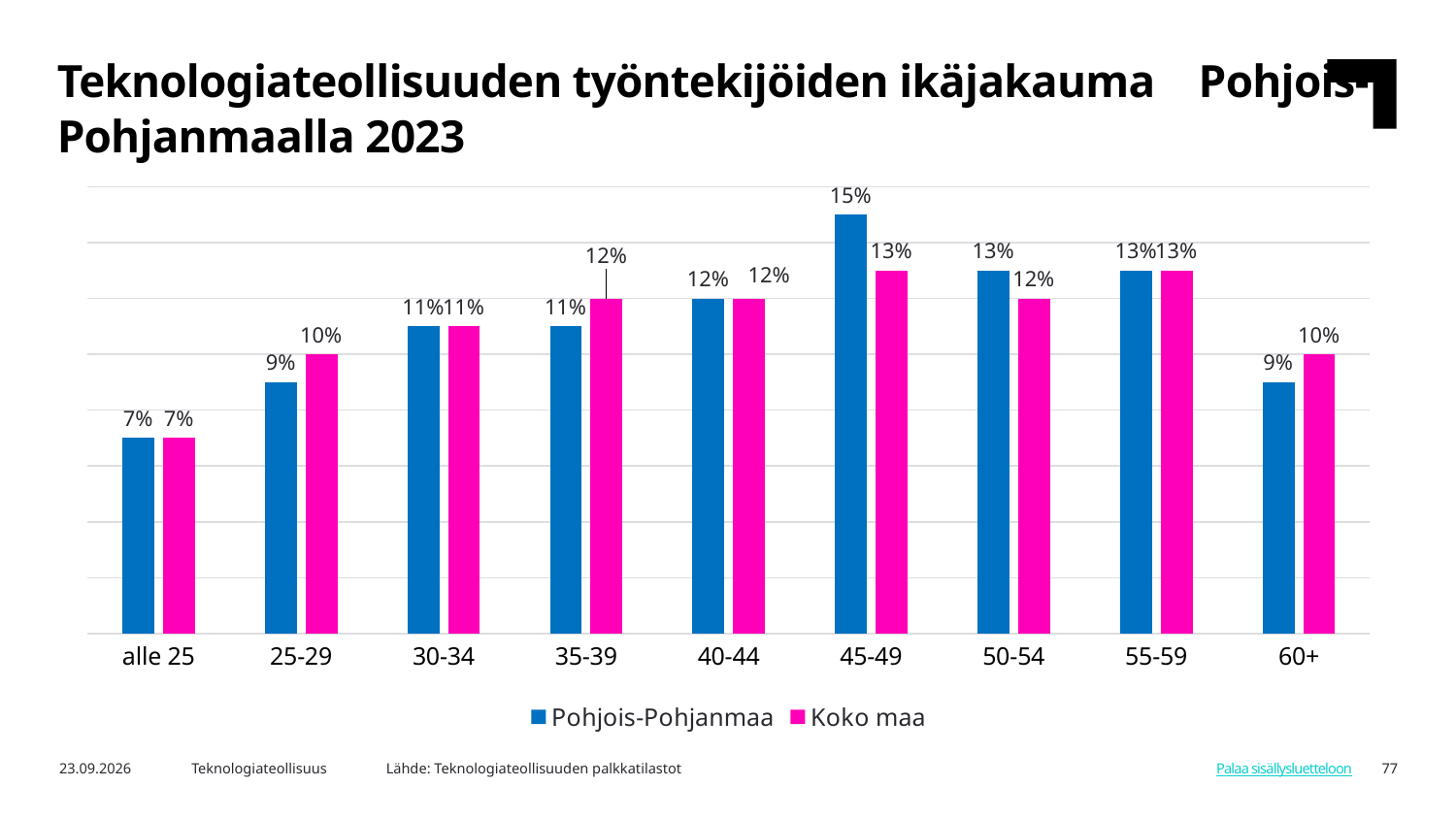
Which age group has the lowest value for Koko maa? alle 25 What kind of chart is shown on the slide? bar chart What is the value for Koko maa in the 35-39 age group? 12% What is the value for Pohjois-Pohjanmaa in the 45-49 age group? 15% Which age group has the highest value for Pohjois-Pohjanmaa? 45-49 How many age groups are shown on the x axis? 9 What is the difference between Pohjois-Pohjanmaa and Koko maa in the 45-49 age group? 2 percentage points In the 50-54 age group, which series has the larger value, Pohjois-Pohjanmaa or Koko maa? Pohjois-Pohjanmaa How many series does the legend list? 2 Which series is shown in pink in the legend? Koko maa What is the value for Koko maa in the 25-29 age group? 10% What is the value for Pohjois-Pohjanmaa in the 60+ age group? 9%